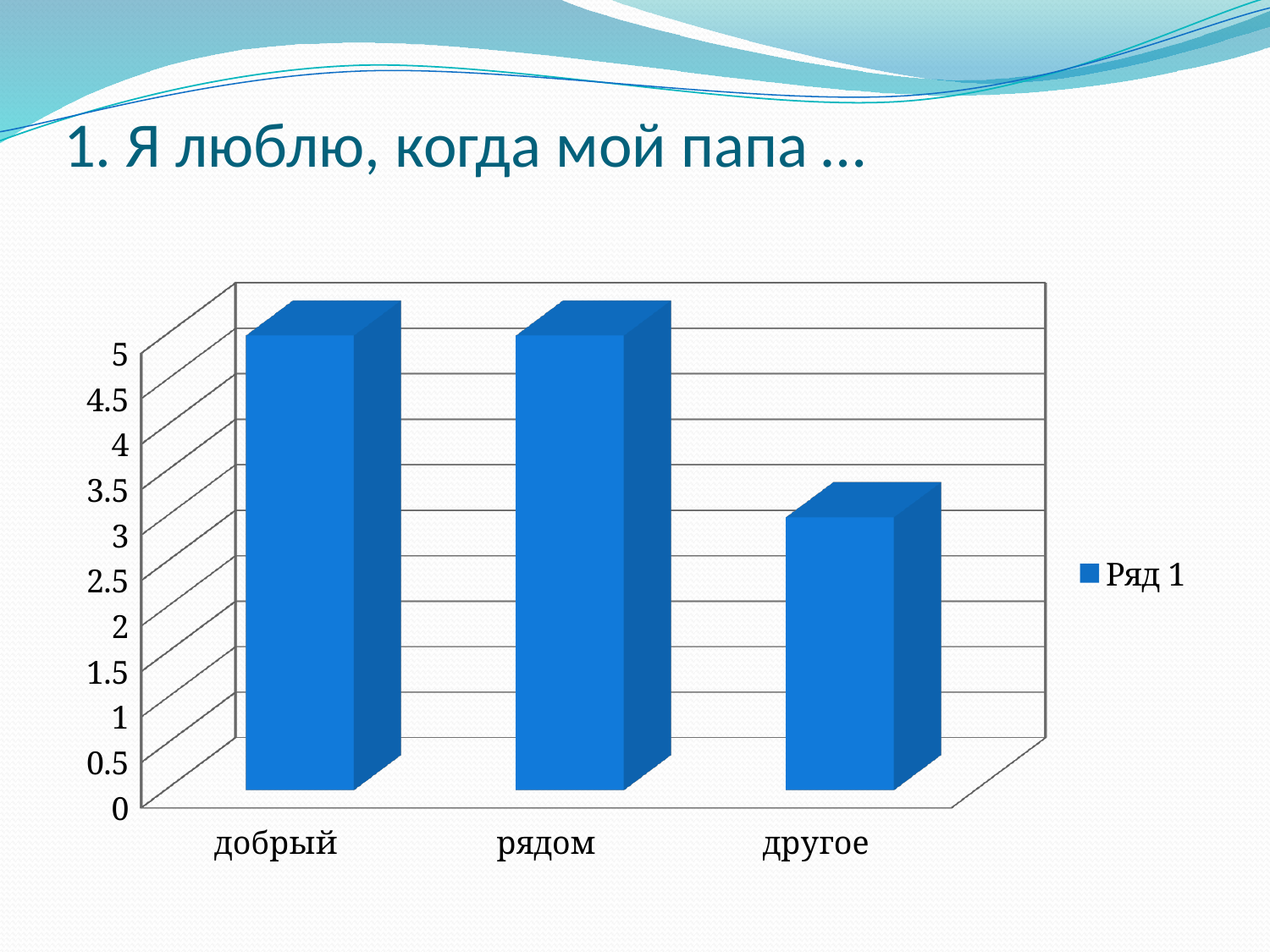
What kind of chart is shown on the slide? bar chart What is the title of the slide containing the chart? 1. Я люблю, когда мой папа … Which category has the lowest value in the chart? другое Is the value for добрый greater or less than 4? greater Is the value for другое greater or less than 2? greater Which is larger, the value for добрый or the value for другое? добрый Is the value for другое greater or less than 4? less Which is larger, the value for рядом or the value for другое? рядом What is the name of the series shown in the chart's legend? Ряд 1 How many categories are shown on the x axis of the chart? 3 How many series does the chart's legend list? 1